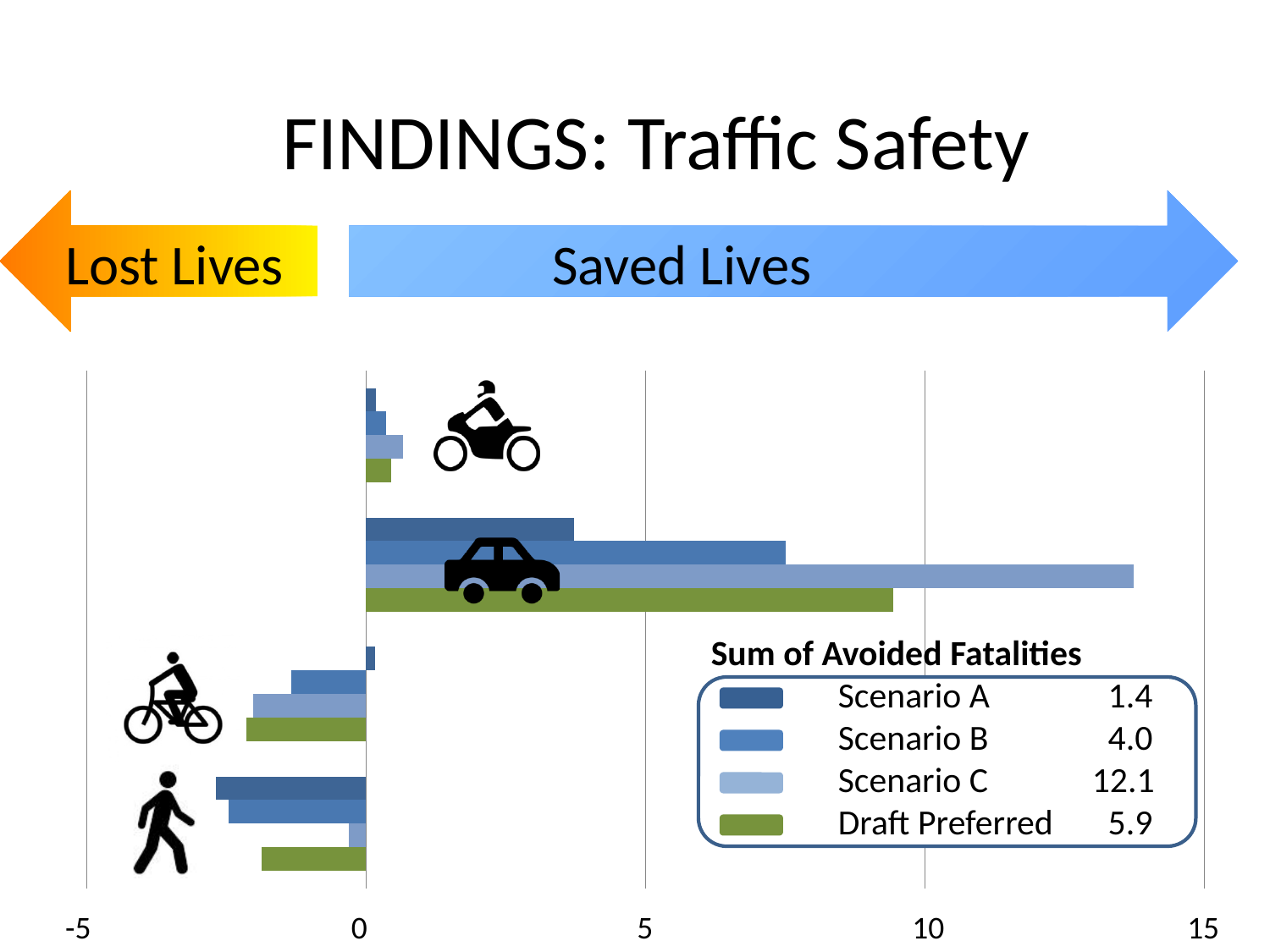
What is the title shown above the legend? Sum of Avoided Fatalities What kind of chart is shown on the slide? bar chart What is the Sum of Avoided Fatalities for Scenario A? 1.4 Is the Draft Preferred bar for the car category greater or less than 5? greater Which series has the lowest Sum of Avoided Fatalities? Scenario A What is the difference between the Sum of Avoided Fatalities for Scenario C and Scenario B? 8.1 What is the Sum of Avoided Fatalities for Draft Preferred? 5.9 How many series does the legend list? 4 Which series has the highest Sum of Avoided Fatalities? Scenario C What is the Sum of Avoided Fatalities for Scenario C? 12.1 Is the Scenario C bar for the car category greater or less than 10? greater Which has a larger Sum of Avoided Fatalities, Draft Preferred or Scenario B? Draft Preferred